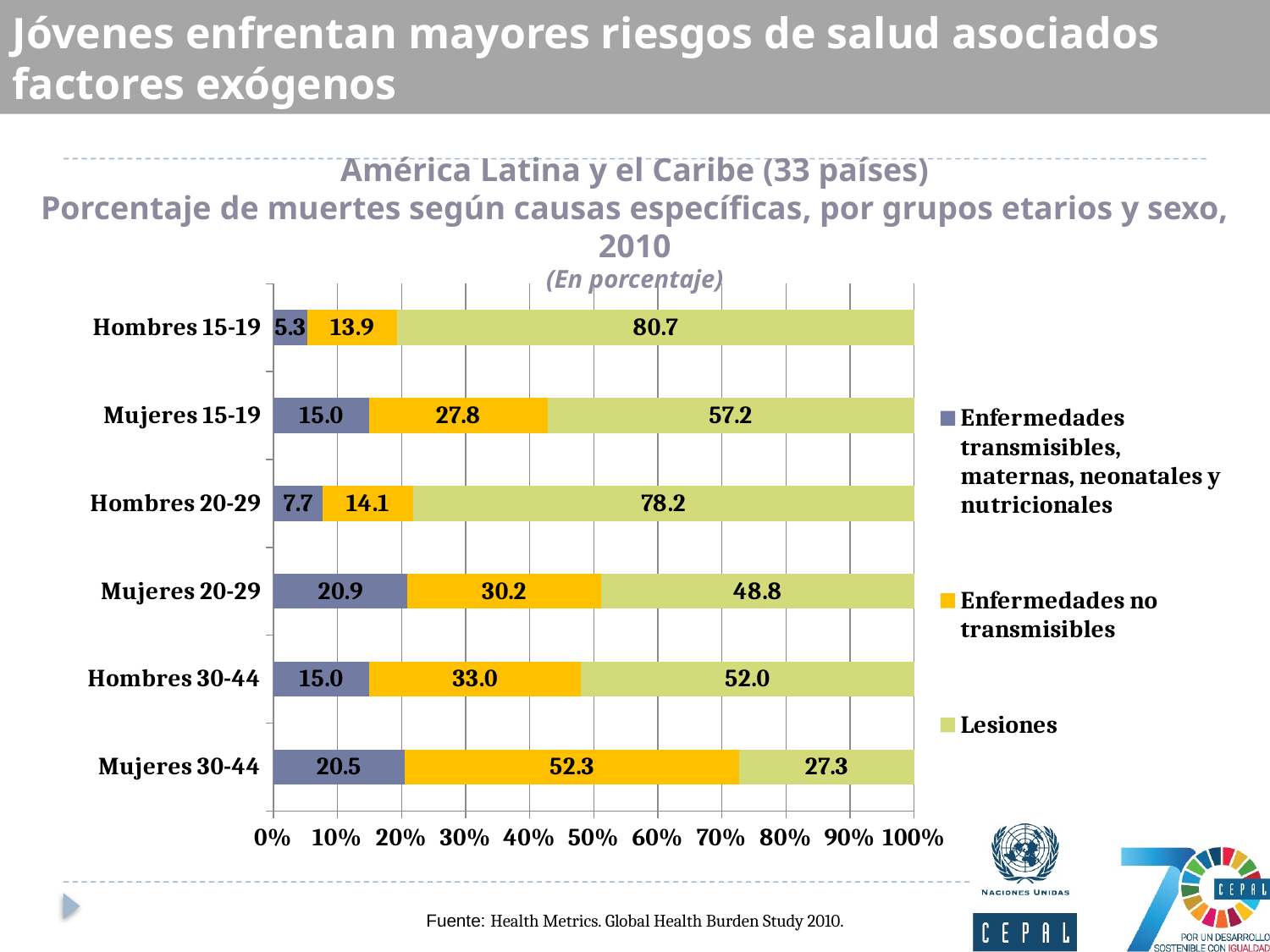
What is the difference in Lesiones between Hombres 15-19 and Mujeres 15-19? 23.5 What is the value of Enfermedades no transmisibles for Mujeres 20-29? 30.2 Which group has the highest value for Enfermedades no transmisibles? Mujeres 30-44 What is the value of Enfermedades transmisibles, maternas, neonatales y nutricionales for Hombres 20-29? 7.7 Which series is shown in yellow in the legend? Enfermedades no transmisibles How many series does the legend list? 3 What is the value of Lesiones for Hombres 15-19? 80.7 Which group has the lowest value for Lesiones? Mujeres 30-44 Which group has the highest value for Lesiones? Hombres 15-19 What kind of chart is shown on the slide? Stacked bar chart How many age-sex groups are shown on the chart? 6 Which is larger, Enfermedades no transmisibles for Mujeres 30-44 or for Hombres 30-44? Mujeres 30-44